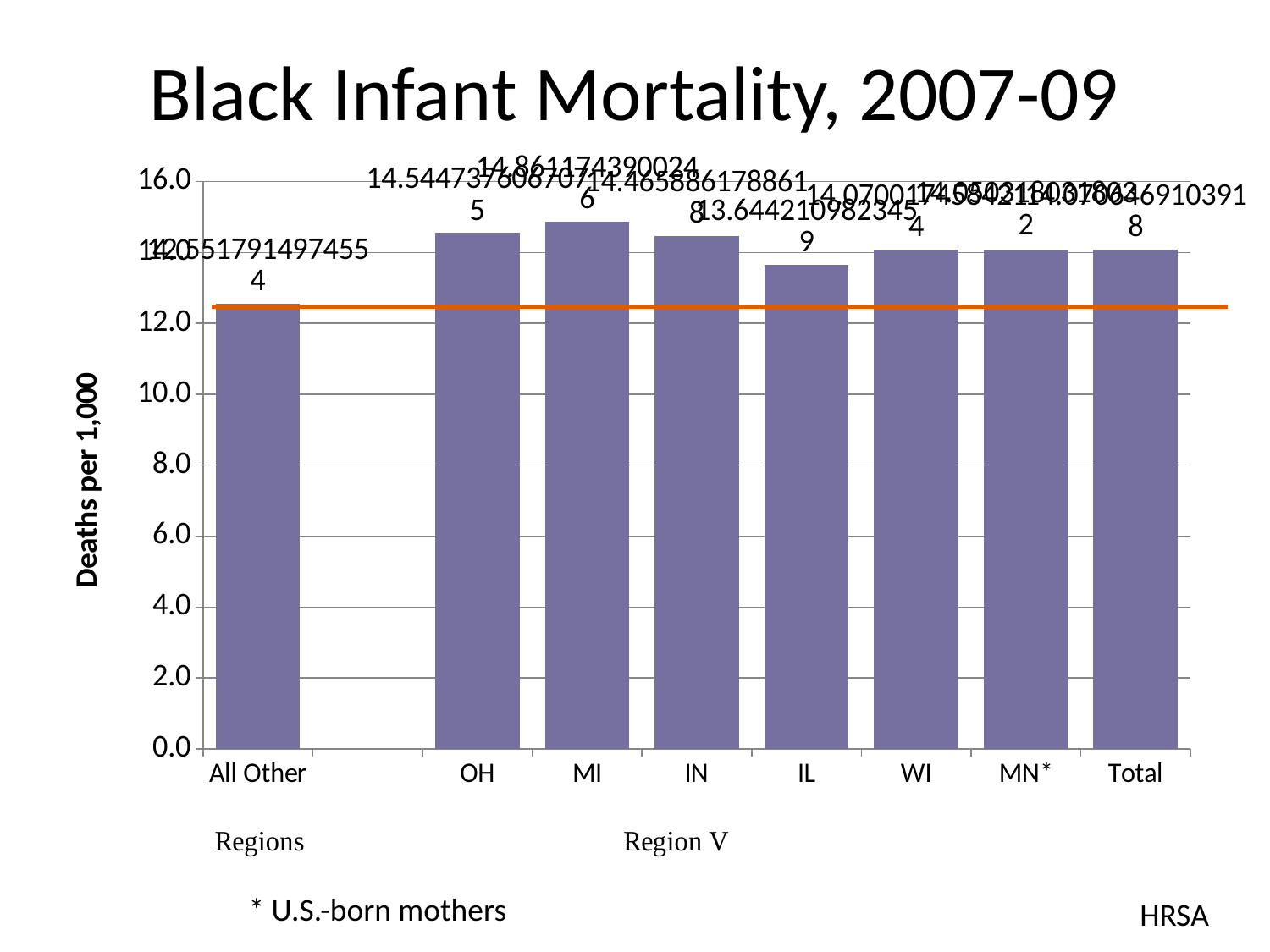
Which is larger, the value for MI or the value for IN? MI Is the value for OH greater or less than 14.0? greater Is the value for IL greater or less than 14.0? less Which category has the highest bar in the chart? MI Is the value for All Other greater or less than 14.0? less Which is larger, the value for OH or the value for IL? OH Which category has the lowest bar in the chart? All Other What is the label on the vertical axis of the chart? Deaths per 1,000 How many bars are plotted in the chart? 8 What is the title of the chart? Black Infant Mortality, 2007-09 What kind of chart is shown on the slide? bar chart